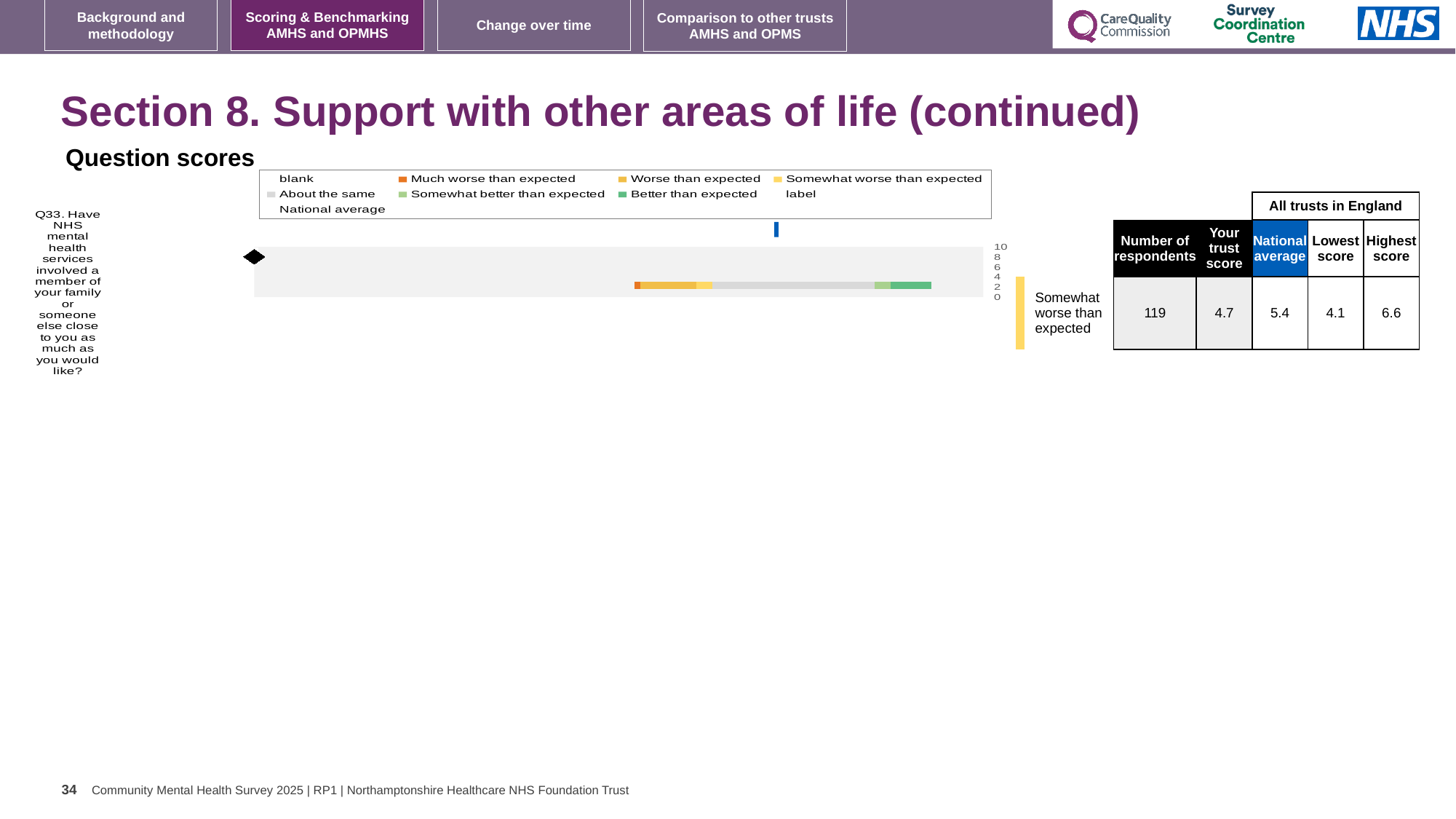
What rating label is shown next to the chart for Q33? Somewhat worse than expected How many entries does the chart legend list? 9 What is the highest score among all trusts in England for Q33? 6.6 What is the national average score for Q33? 5.4 How many questions (categories) are plotted in the chart? 1 Which is larger for Q33, the trust's score or the national average? national average What kind of chart is shown on the slide? bar chart What is the trust's score for Q33? 4.7 What is the lowest score among all trusts in England for Q33? 4.1 What is the number of respondents for Q33? 119 What is the difference between the highest and lowest scores among all trusts in England for Q33? 2.5 Which question is plotted in the chart? Q33. Have NHS mental health services involved a member of your family or someone else close to you as much as you would like?